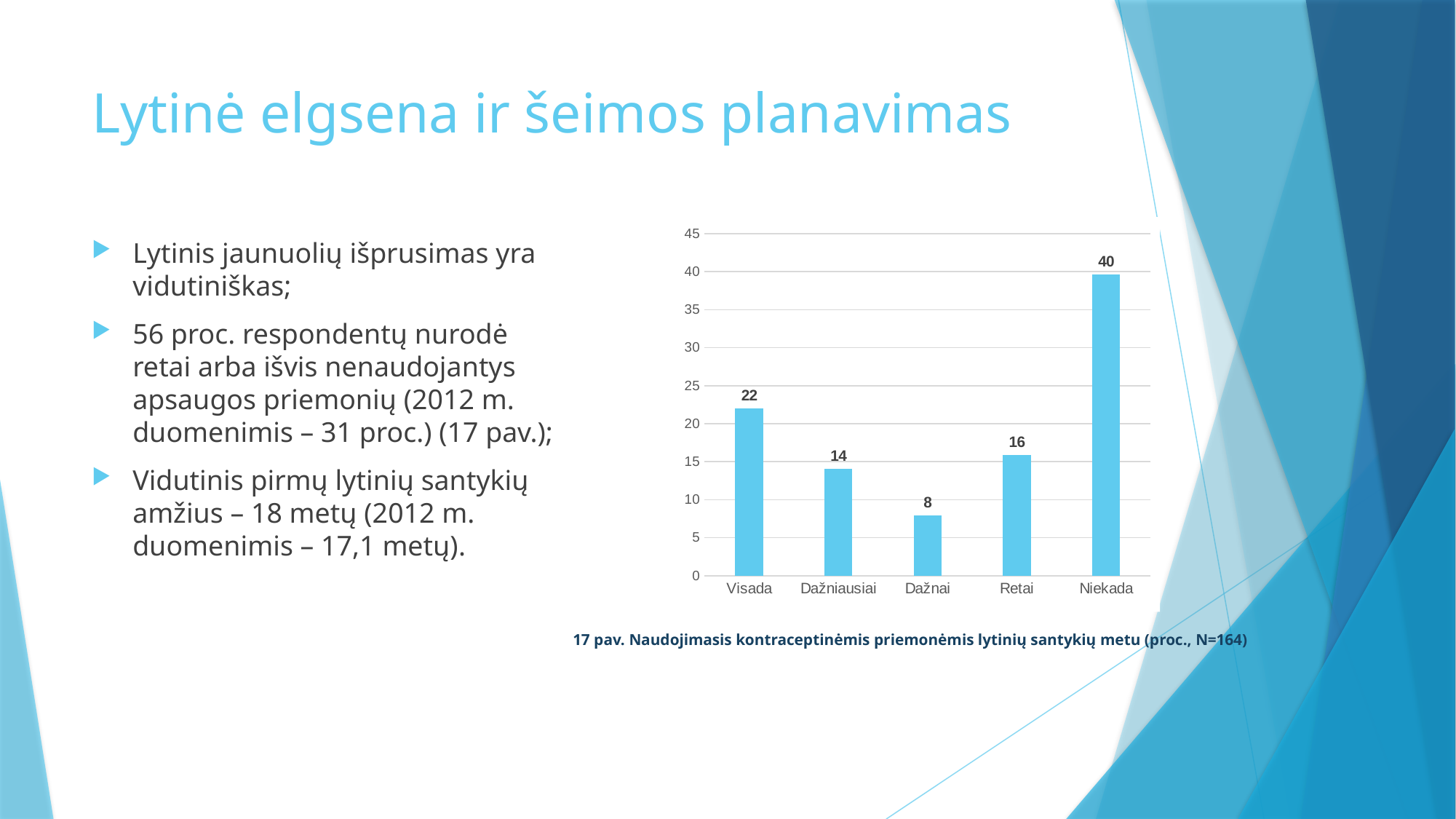
What is the caption of the chart? 17 pav. Naudojimasis kontraceptinėmis priemonėmis lytinių santykių metu (proc., N=164) Which is larger, the value for Retai or the value for Dažniausiai? Retai How many categories are shown on the x axis? 5 What kind of chart is shown on the slide? bar chart What is the sum of the values for Retai and Niekada? 56 Is the value for Visada greater or less than 20? greater What is the value for Niekada? 40 Which category has the lowest value? Dažnai What is the difference between the values for Niekada and Visada? 18 What is the value for Visada? 22 What is the value for Dažnai? 8 Which category has the highest value? Niekada